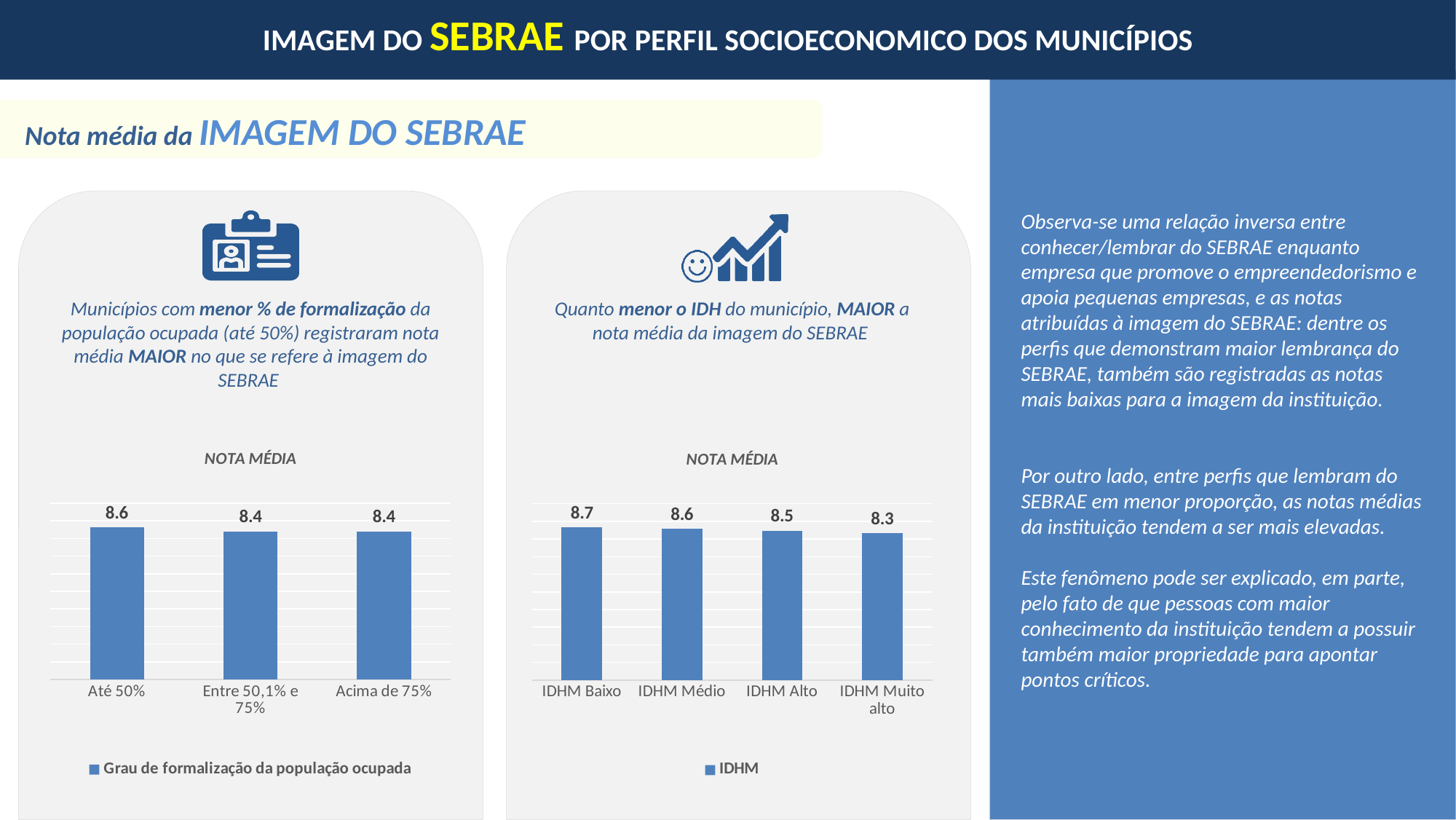
What type of chart is the right chart (IDHM)? bar chart In the left chart (Grau de formalização da população ocupada), which category has the highest value? Até 50% In the right chart (IDHM), how many categories are shown? 4 In the right chart (IDHM), what is the value for 'IDHM Baixo'? 8.7 In the right chart (IDHM), do the values rise or fall from 'IDHM Baixo' to 'IDHM Muito alto'? fall In the left chart (Grau de formalização da população ocupada), what is the value for 'Acima de 75%'? 8.4 In the left chart (Grau de formalização da população ocupada), what is the value for 'Até 50%'? 8.6 In the left chart (Grau de formalização da população ocupada), how many categories are shown? 3 In the right chart (IDHM), which category has the lowest value? IDHM Muito alto In the right chart (IDHM), what is the difference between 'IDHM Baixo' and 'IDHM Muito alto'? 0.4 In the right chart (IDHM), what is the value for 'IDHM Muito alto'? 8.3 In the left chart (Grau de formalização da população ocupada), what is the difference between 'Até 50%' and 'Entre 50,1% e 75%'? 0.2